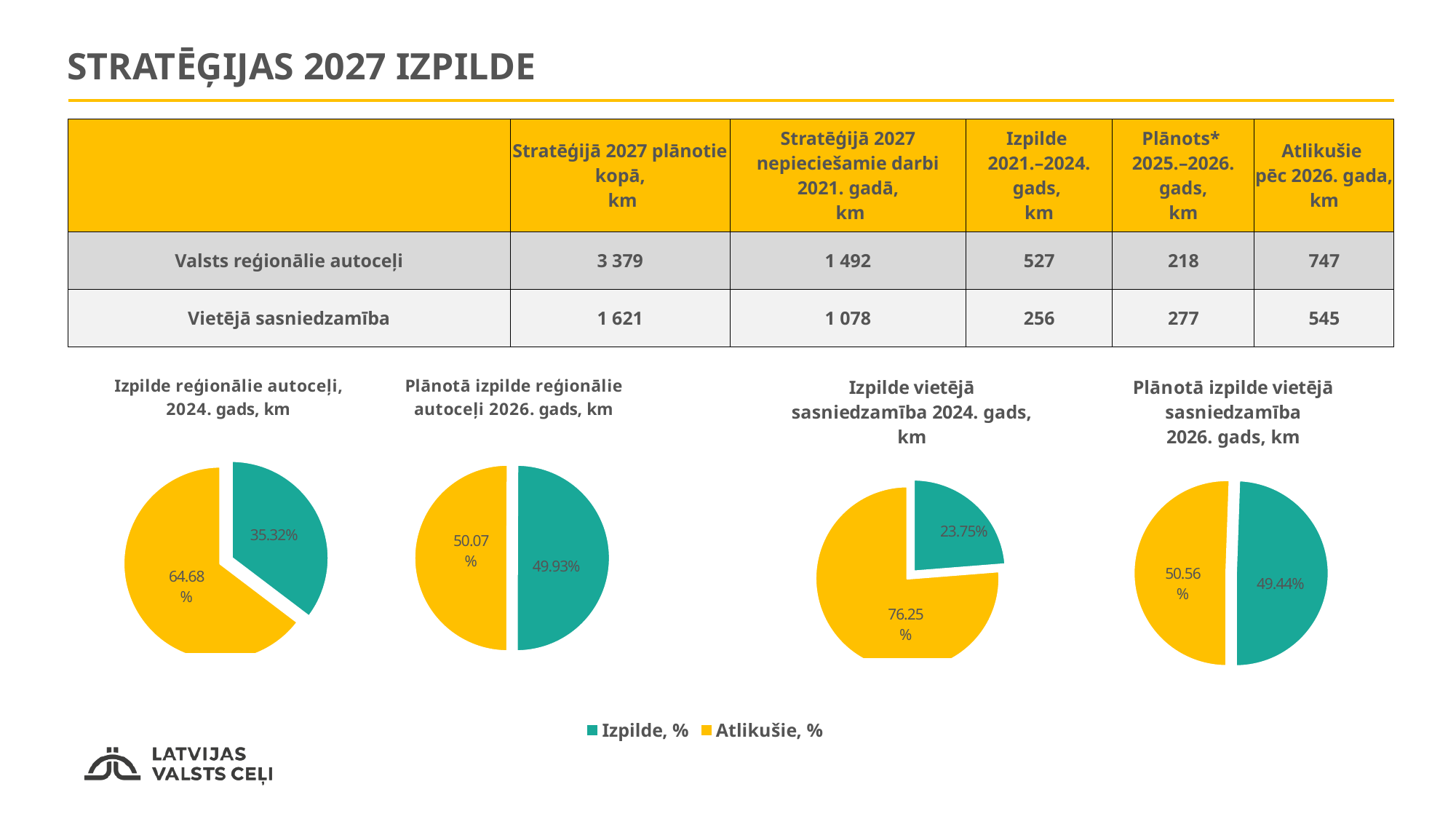
In the chart titled "Izpilde vietējā sasniedzamība 2024. gads, km", what share does the Atlikušie, % slice have? 76.25% In the chart titled "Izpilde reģionālie autoceļi, 2024. gads, km", which slice is larger, Izpilde, % or Atlikušie, %? Atlikušie, % In the chart titled "Plānotā izpilde vietējā sasniedzamība 2026. gads, km", what is the value of the Izpilde, % slice? 49.44% In the chart titled "Izpilde reģionālie autoceļi, 2024. gads, km", what share does the Izpilde, % slice have? 35.32% What kind of chart is "Izpilde reģionālie autoceļi, 2024. gads, km"? Pie chart How many series does the shared legend below the pie charts list? 2 In the chart titled "Izpilde vietējā sasniedzamība 2024. gads, km", what is the difference between the Atlikušie, % and Izpilde, % slices? 52.50% In the chart titled "Izpilde reģionālie autoceļi, 2024. gads, km", what is the value of the Atlikušie, % slice? 64.68% In the chart titled "Plānotā izpilde vietējā sasniedzamība 2026. gads, km", what is the value of the Atlikušie, % slice? 50.56% In the chart titled "Izpilde vietējā sasniedzamība 2024. gads, km", what is the value of the Izpilde, % slice? 23.75% In the chart titled "Plānotā izpilde reģionālie autoceļi 2026. gads, km", what is the value of the Atlikušie, % slice? 50.07% In the chart titled "Plānotā izpilde reģionālie autoceļi 2026. gads, km", what share does the Izpilde, % slice have? 49.93%